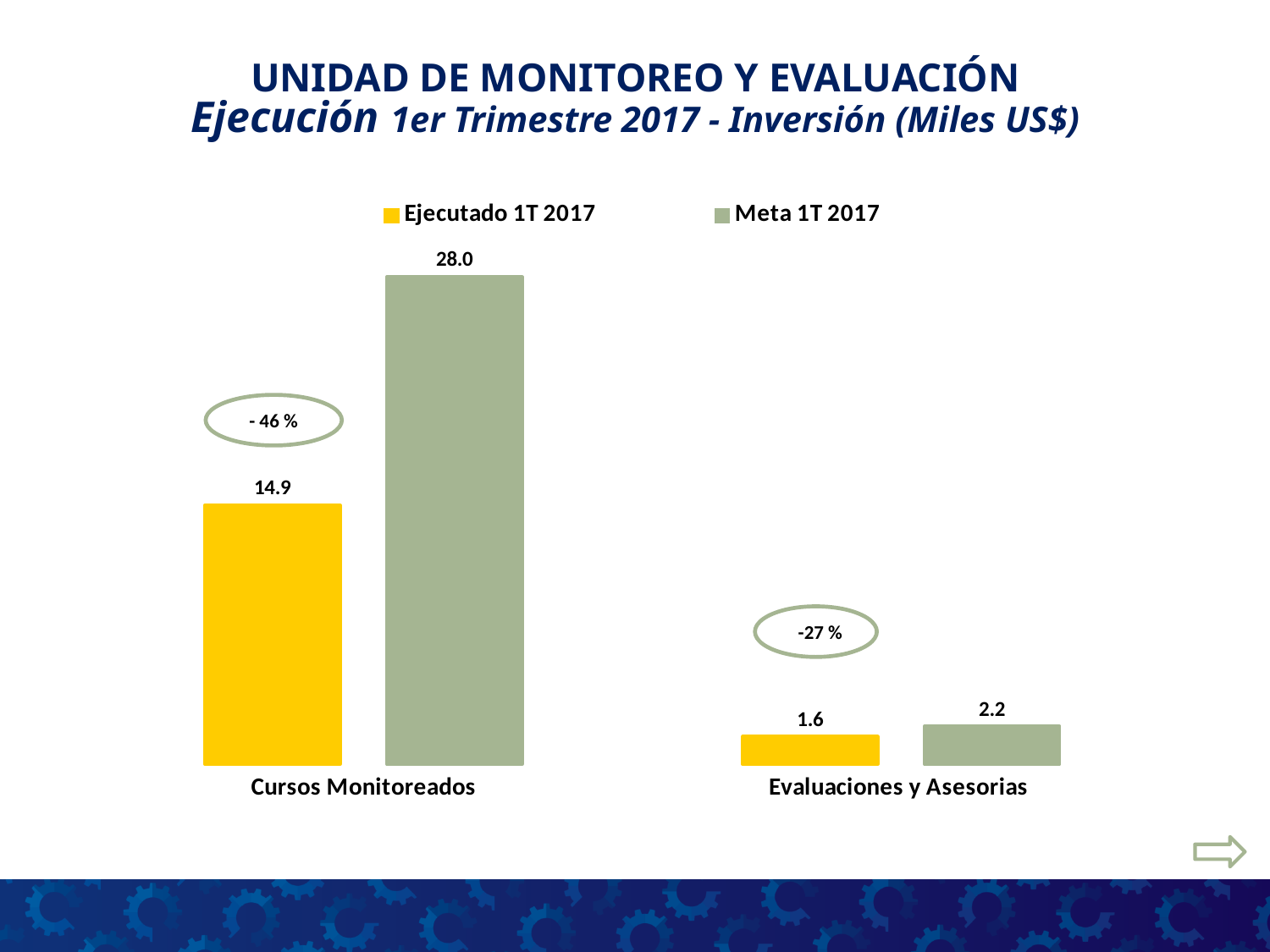
What is the Meta 1T 2017 value for Cursos Monitoreados? 28.0 Which category has the lowest Ejecutado 1T 2017 value? Evaluaciones y Asesorias How many series does the legend list? 2 What is the Ejecutado 1T 2017 value for Evaluaciones y Asesorias? 1.6 What is the difference between the Meta 1T 2017 and Ejecutado 1T 2017 values for Evaluaciones y Asesorias? 0.6 What kind of chart is shown on the slide? Bar chart What is the Meta 1T 2017 value for Evaluaciones y Asesorias? 2.2 Which category has the highest Meta 1T 2017 value? Cursos Monitoreados What is the difference between the Meta 1T 2017 and Ejecutado 1T 2017 values for Cursos Monitoreados? 13.1 For Cursos Monitoreados, which is larger: Ejecutado 1T 2017 or Meta 1T 2017? Meta 1T 2017 How many categories are shown on the x axis? 2 What is the Ejecutado 1T 2017 value for Cursos Monitoreados? 14.9